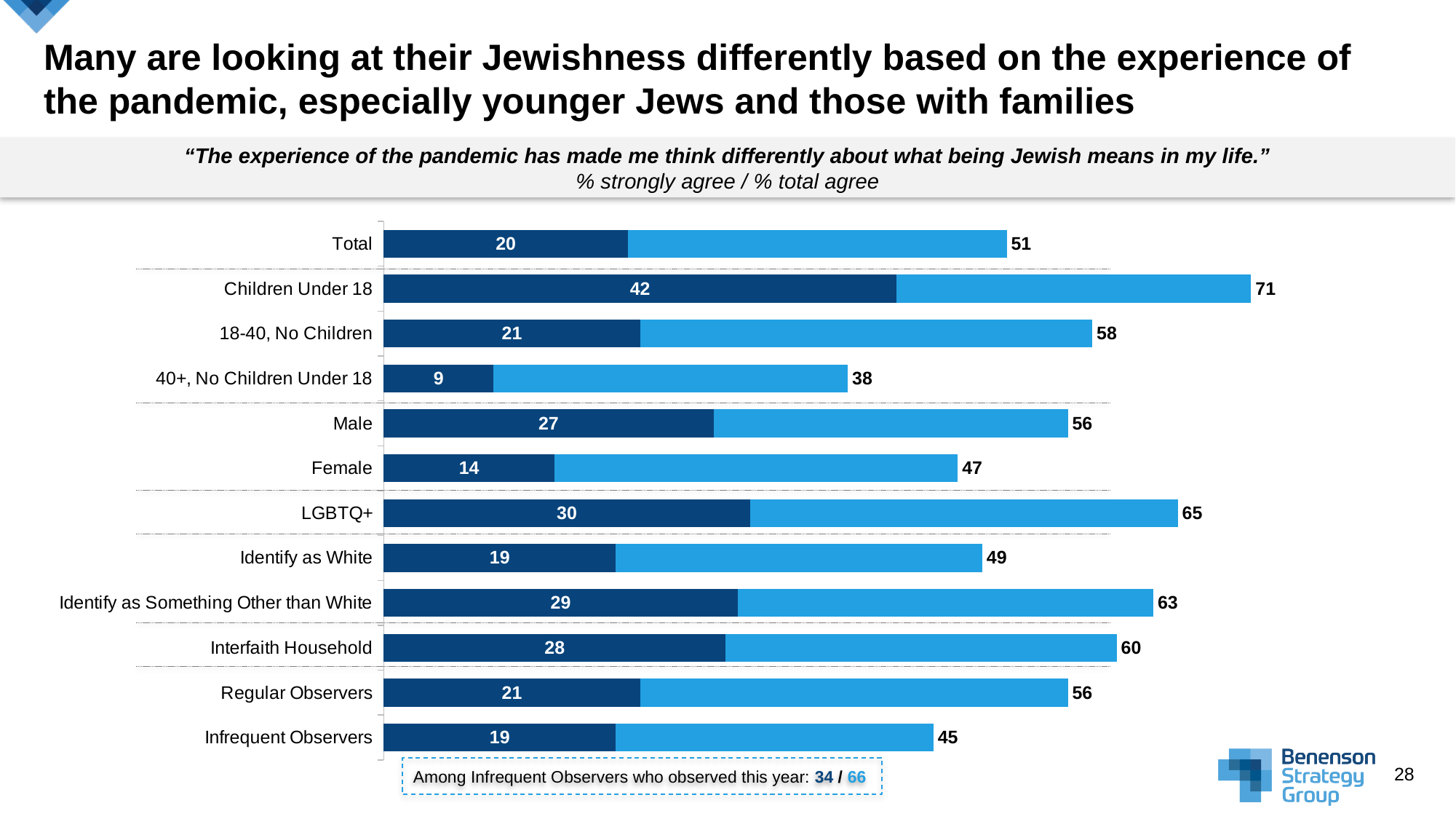
What is the % total agree for Regular Observers? 56 What type of chart is shown on the slide? Stacked bar chart How many groups (bars) are shown in the chart? 12 According to the note below the chart, what are the % strongly agree / % total agree among Infrequent Observers who observed this year? 34 / 66 Which group has the lowest % strongly agree? 40+, No Children Under 18 What is the difference in % strongly agree between Children Under 18 and 18-40, No Children? 21 What percentage of Children Under 18 strongly agree that the pandemic made them think differently about what being Jewish means? 42 Which group has the highest % total agree? Children Under 18 Which has a higher % strongly agree, LGBTQ+ or Interfaith Household? LGBTQ+ What is the % strongly agree for Female respondents? 14 What is the difference in % total agree between Male and Female respondents? 9 What is the % total agree for the 40+, No Children Under 18 group? 38